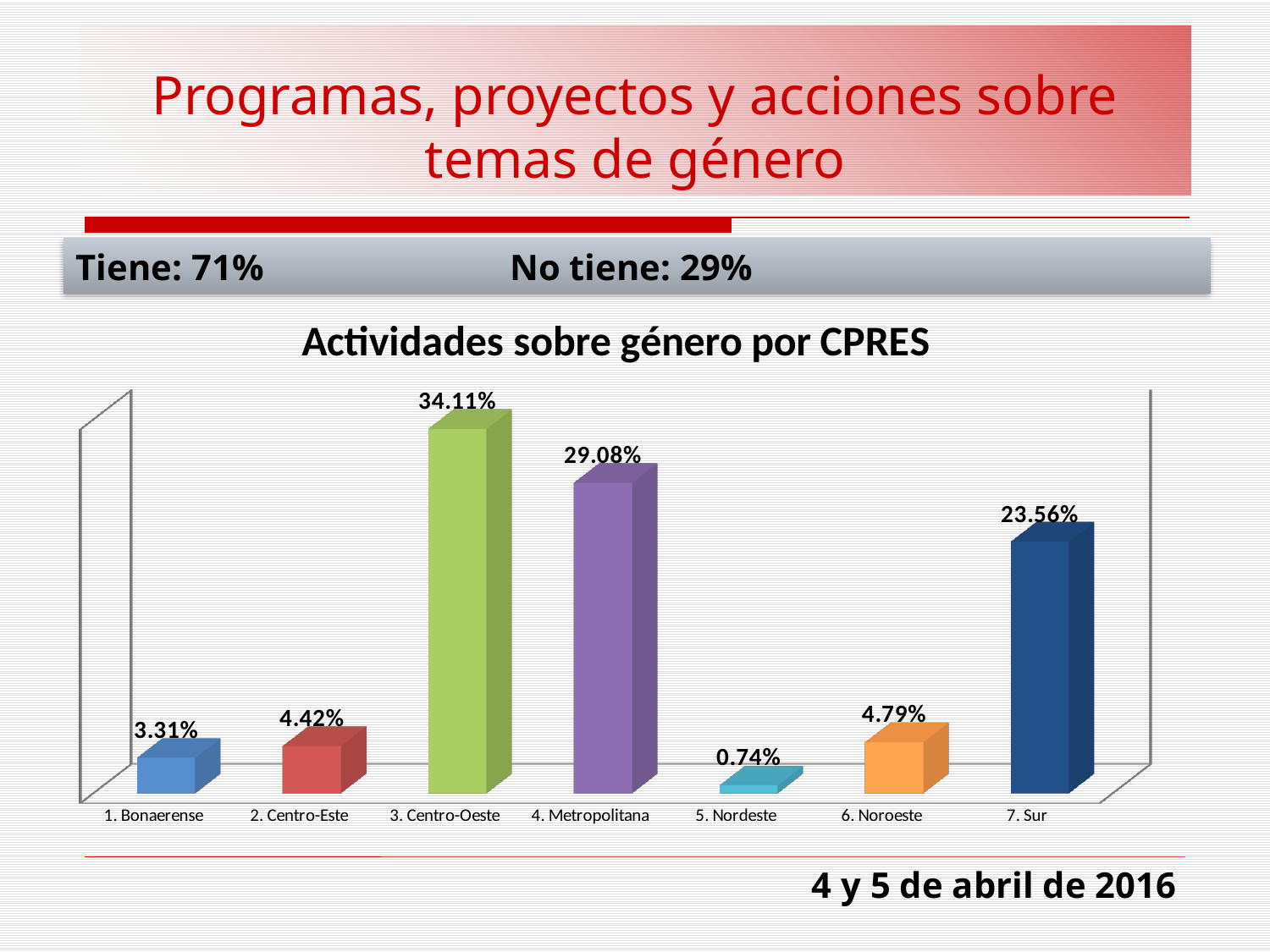
How many categories are shown on the x axis? 7 What is the title of the chart? Actividades sobre género por CPRES What is the value for 3. Centro-Oeste? 34.11% What is the difference between the values for 3. Centro-Oeste and 4. Metropolitana? 5.03% What is the value for 7. Sur? 23.56% Which is larger, the value for 4. Metropolitana or the value for 7. Sur? 4. Metropolitana Which category has the lowest value? 5. Nordeste Which category has the highest value? 3. Centro-Oeste What is the difference between the values for 6. Noroeste and 2. Centro-Este? 0.37% What is the value for 1. Bonaerense? 3.31% What kind of chart is shown? bar chart What is the value for 5. Nordeste? 0.74%